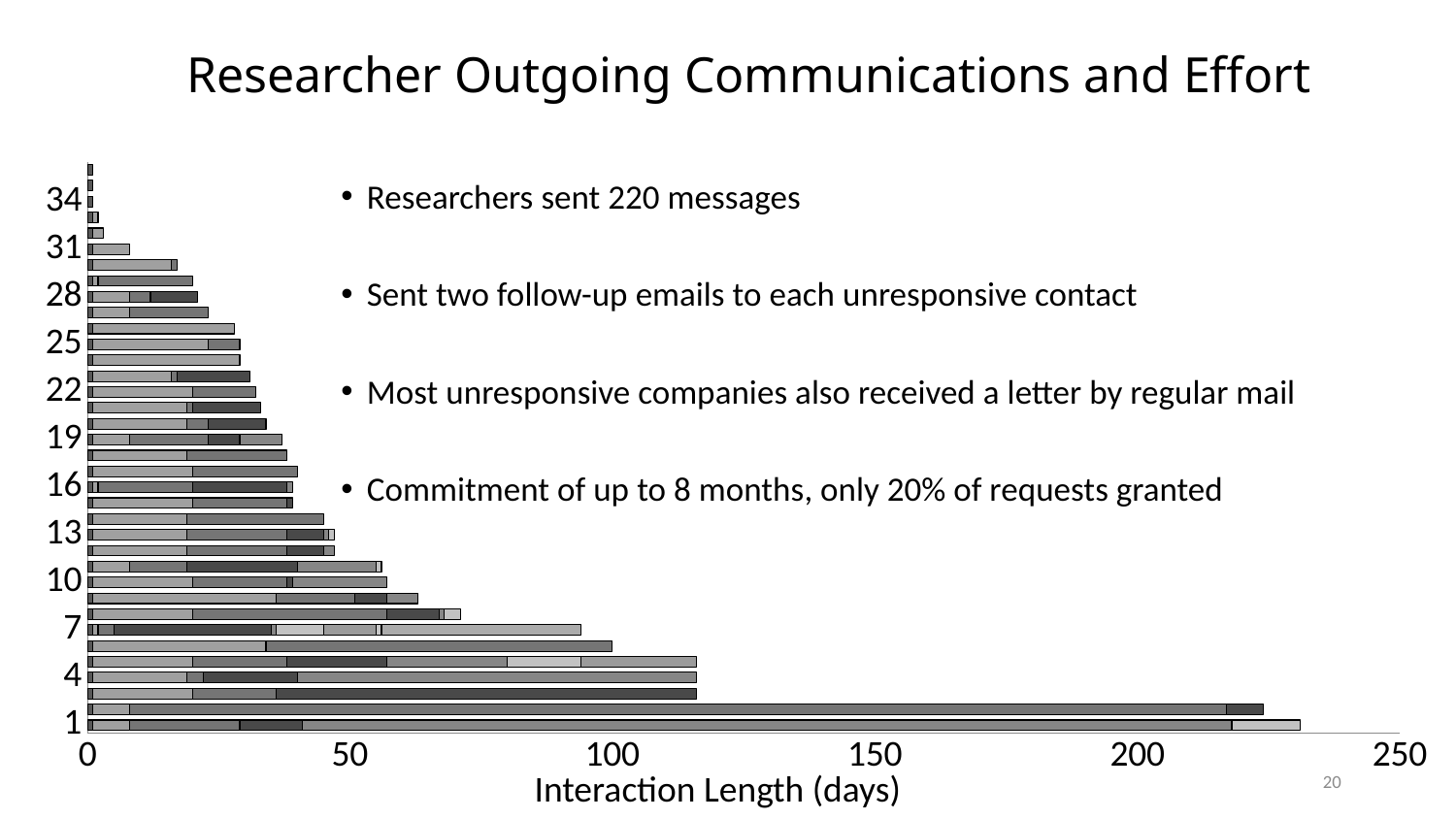
What is the title of the x axis of the chart? Interaction Length (days) Which has the longer total interaction length, category 1 or category 34? category 1 Is the total interaction length for category 31 greater or less than 50 days? less Is the total interaction length for category 4 greater or less than 100 days? greater Is the total interaction length for category 16 greater or less than 50 days? less What kind of chart is shown on the slide? bar chart What is the highest value shown on the x axis of the chart? 250 Which has the longer total interaction length, category 4 or category 16? category 4 Do the bar lengths generally rise or fall as the category number increases from 1 upward? fall